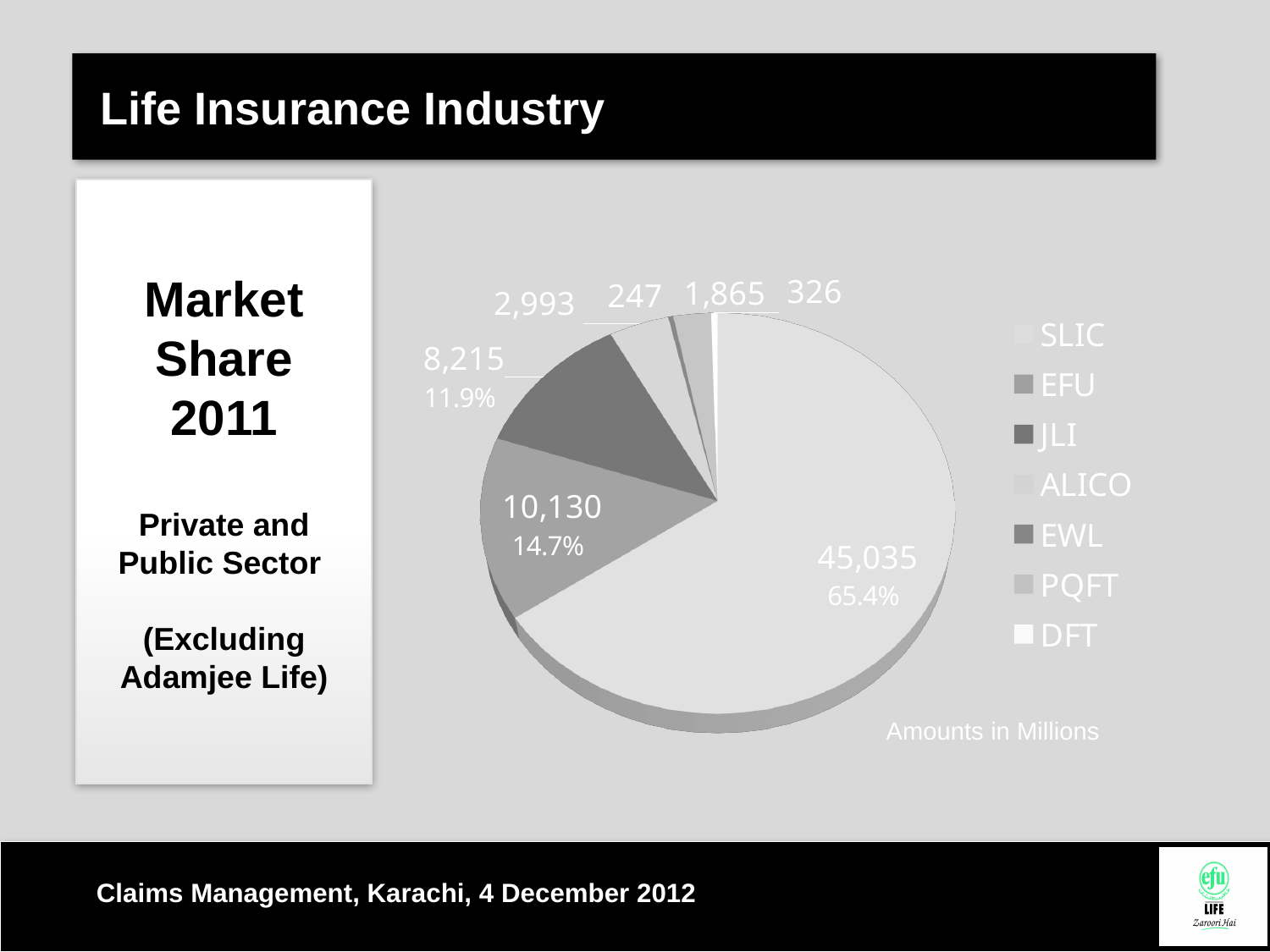
What is the value shown for JLI in the pie chart? 8,215 What is the value shown for SLIC in the pie chart? 45,035 What share of the pie does SLIC hold? 65.4% How many slices does the pie chart have? 7 What is the difference between the values for EFU and JLI? 1,915 What share of the pie does EFU hold? 14.7% Which is larger, the value for ALICO or the value for PQFT? ALICO Which company has the smallest slice of the pie chart? EWL Which company has the largest slice of the pie chart? SLIC How many entries does the legend of the pie chart list? 7 What is the value shown for EFU in the pie chart? 10,130 What kind of chart is shown on the slide? pie chart